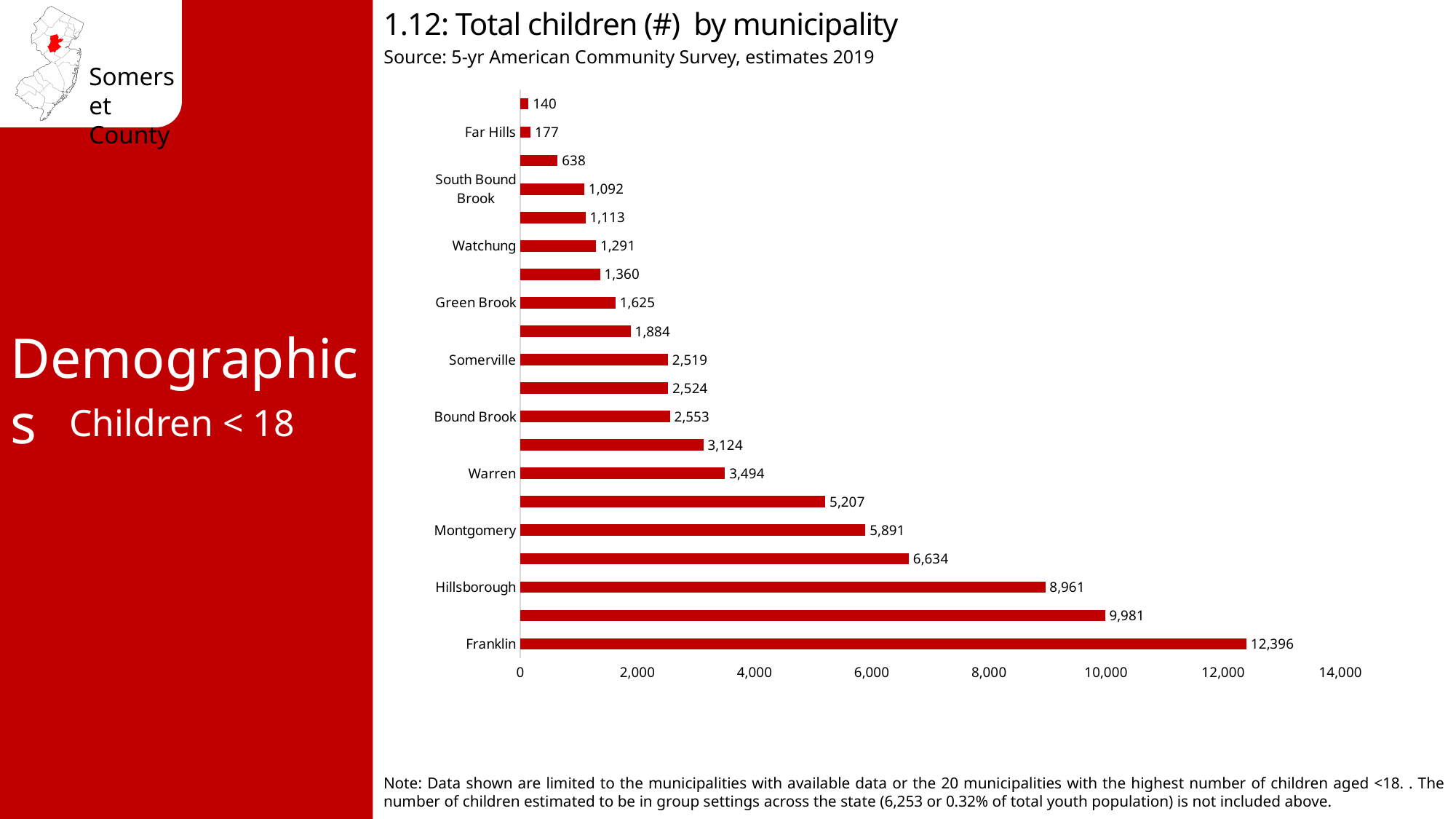
What is the smallest value shown on the chart? 140 What is the total number of children for Franklin? 12,396 What is the total number of children for Montgomery? 5,891 How many bars are plotted on the chart? 20 What is the title of the chart? 1.12: Total children (#) by municipality What kind of chart is shown on the slide? bar chart Which labeled municipality has the highest number of children? Franklin Is the value for Montgomery greater or less than 6,000? less What is the difference between the values for Franklin and Hillsborough? 3,435 What is the total number of children for Far Hills? 177 What is the total number of children for Hillsborough? 8,961 Which has more children, Warren or Somerville? Warren